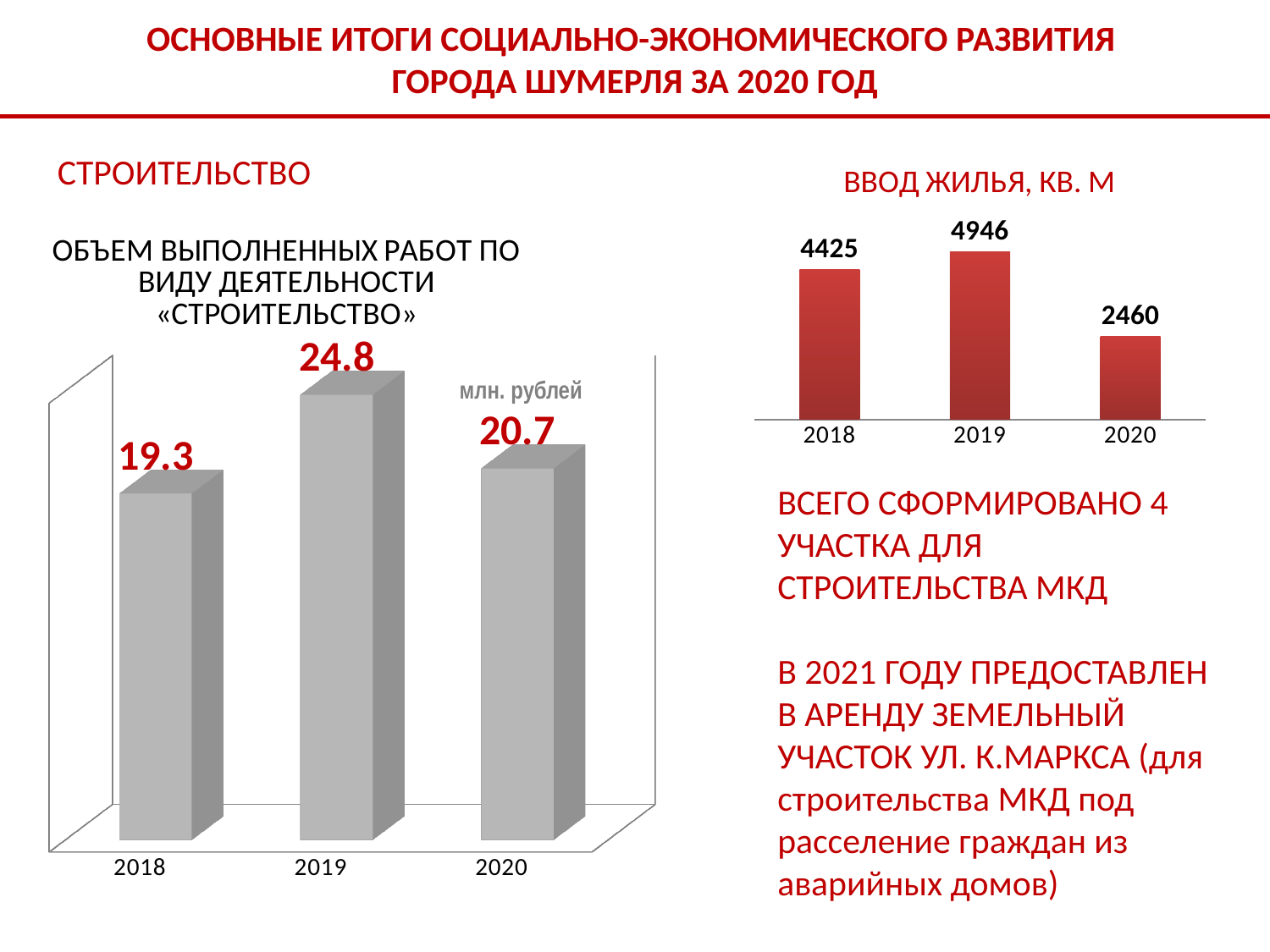
In the chart titled «ОБЪЕМ ВЫПОЛНЕННЫХ РАБОТ ПО ВИДУ ДЕЯТЕЛЬНОСТИ «СТРОИТЕЛЬСТВО»», which year has the highest value? 2019 In the chart titled «ВВОД ЖИЛЬЯ, КВ. М», what is the value for 2018? 4425 In the chart titled «ОБЪЕМ ВЫПОЛНЕННЫХ РАБОТ ПО ВИДУ ДЕЯТЕЛЬНОСТИ «СТРОИТЕЛЬСТВО»», what is the difference between the 2019 and 2020 values? 4.1 In the chart titled «ОБЪЕМ ВЫПОЛНЕННЫХ РАБОТ ПО ВИДУ ДЕЯТЕЛЬНОСТИ «СТРОИТЕЛЬСТВО»», what unit is shown for the values? млн. рублей In the chart titled «ВВОД ЖИЛЬЯ, КВ. М», what is the value for 2020? 2460 In the chart titled «ОБЪЕМ ВЫПОЛНЕННЫХ РАБОТ ПО ВИДУ ДЕЯТЕЛЬНОСТИ «СТРОИТЕЛЬСТВО»», what is the value for 2018? 19.3 In the chart titled «ВВОД ЖИЛЬЯ, КВ. М», which year has the highest value? 2019 In the chart titled «ОБЪЕМ ВЫПОЛНЕННЫХ РАБОТ ПО ВИДУ ДЕЯТЕЛЬНОСТИ «СТРОИТЕЛЬСТВО»», which year has the lowest value? 2018 In the chart titled «ВВОД ЖИЛЬЯ, КВ. М», is the value for 2019 or 2020 larger? 2019 In the chart titled «ОБЪЕМ ВЫПОЛНЕННЫХ РАБОТ ПО ВИДУ ДЕЯТЕЛЬНОСТИ «СТРОИТЕЛЬСТВО»», what is the value for 2019? 24.8 In the chart titled «ВВОД ЖИЛЬЯ, КВ. М», how many years are shown? 3 In the chart titled «ВВОД ЖИЛЬЯ, КВ. М», what is the difference between the 2019 and 2018 values? 521